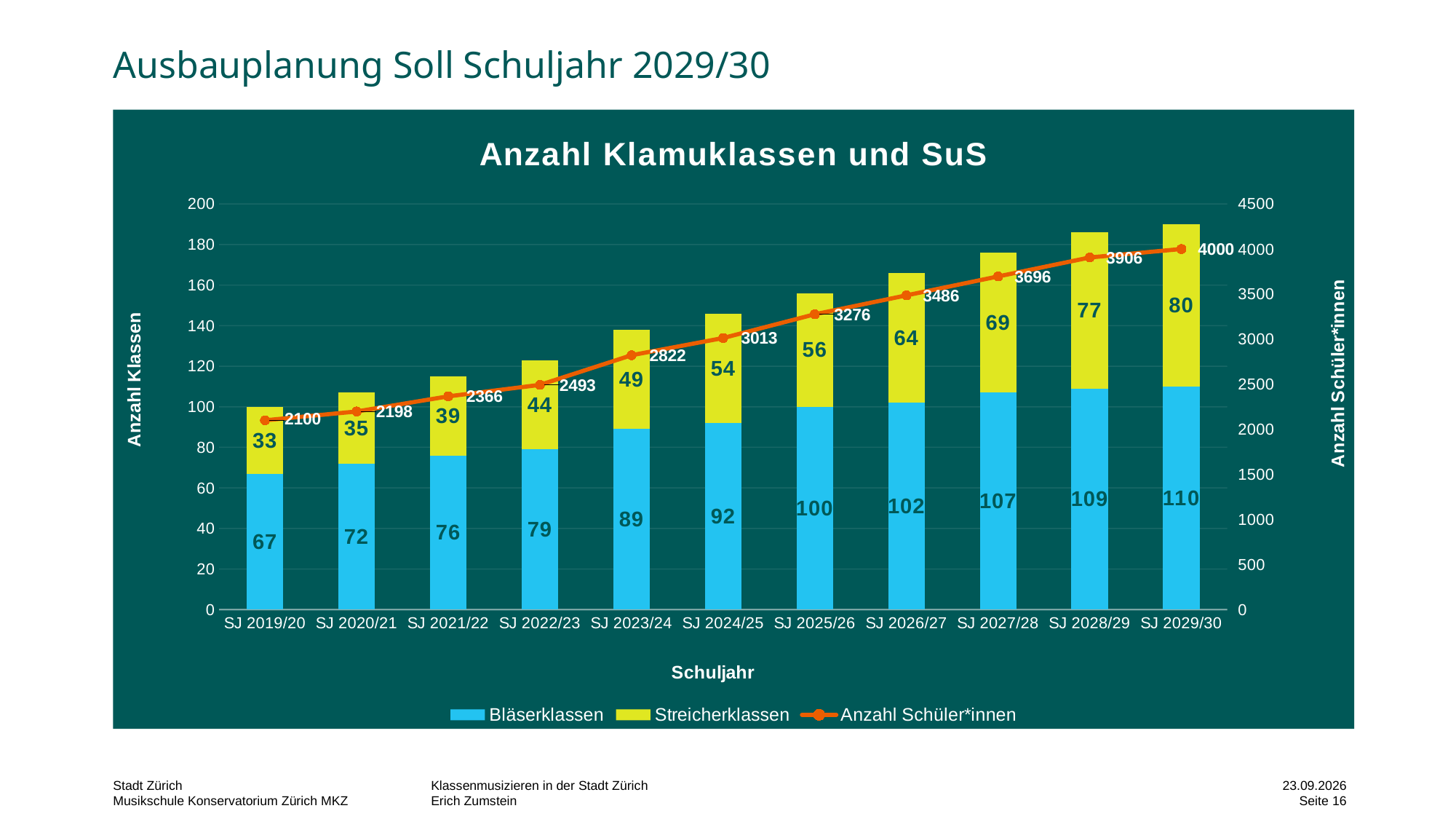
What is the value for Bläserklassen in SJ 2023/24? 89 Which school year has the highest value for Anzahl Schüler*innen? SJ 2029/30 Does the Anzahl Schüler*innen line rise or fall from SJ 2019/20 to SJ 2029/30? rise How many series does the legend list? 3 What is the title of the chart? Anzahl Klamuklassen und SuS Which is larger: Streicherklassen in SJ 2024/25 or Streicherklassen in SJ 2021/22? SJ 2024/25 What is the total of the stacked bar for SJ 2022/23? 123 What is the value of Anzahl Schüler*innen in SJ 2025/26? 3276 What is the value for Streicherklassen in SJ 2026/27? 64 How many school years are shown on the x axis? 11 Which school year has the lowest value for Bläserklassen? SJ 2019/20 What is the difference between the Bläserklassen values for SJ 2029/30 and SJ 2019/20? 43